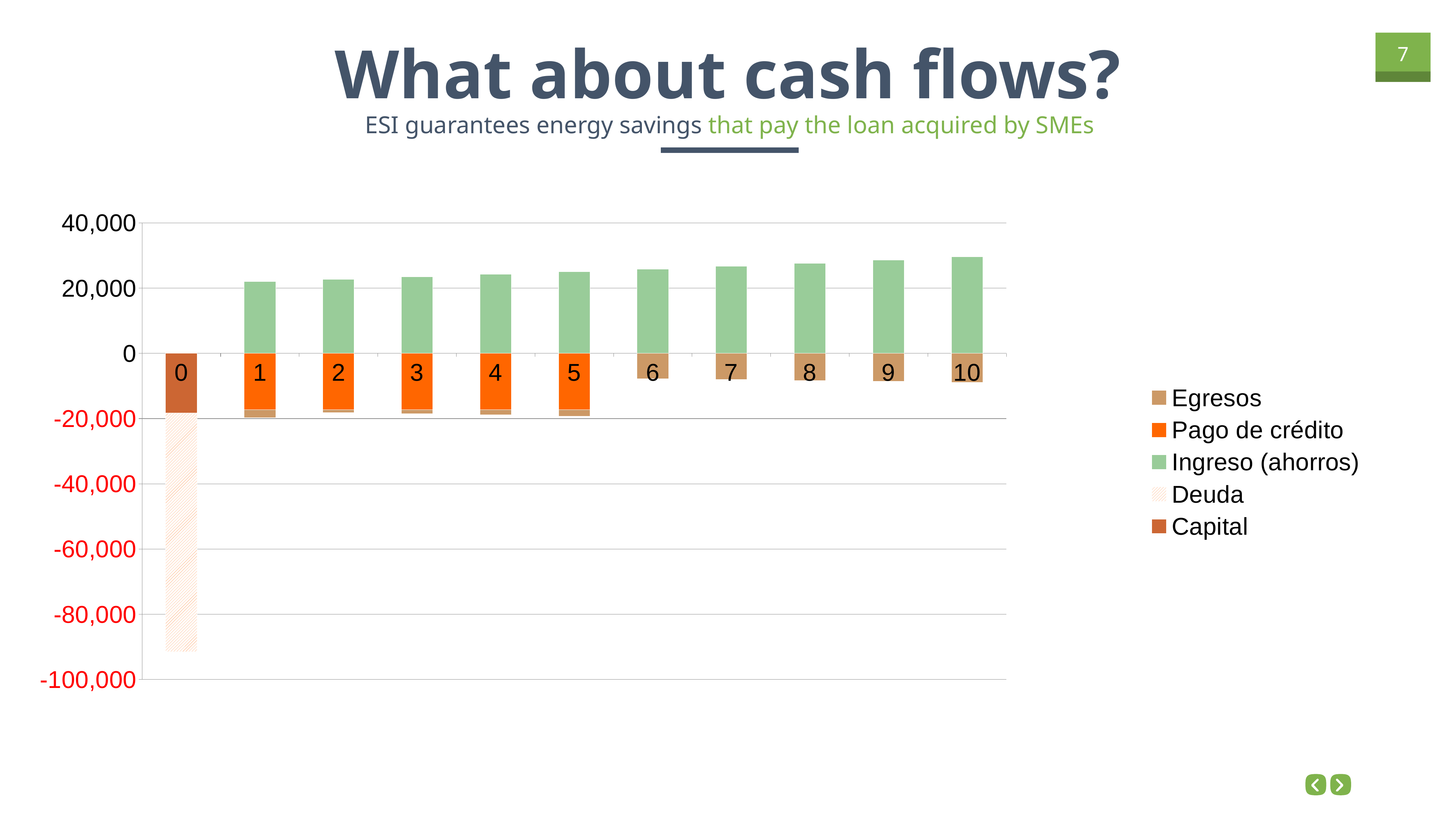
Which series is shown in green in the chart? Ingreso (ahorros) Do the Ingreso (ahorros) values rise or fall from year 1 to year 10? rise Which series is drawn with a hatched pattern in the chart? Deuda Is the bottom of the Deuda segment for year 0 greater or less than -80,000? less Which is larger, the Ingreso (ahorros) value for year 10 or for year 1? year 10 How many categories (years) are shown on the x axis of the chart? 11 What kind of chart is shown on the slide? stacked bar chart How many series does the chart legend list? 5 Is the Egresos value for year 6 greater or less than -20,000? greater Is the Ingreso (ahorros) value for year 10 greater or less than 20,000? greater In which year does the Capital series appear in the chart? 0 In which year does the Ingreso (ahorros) bar reach its highest value? 10